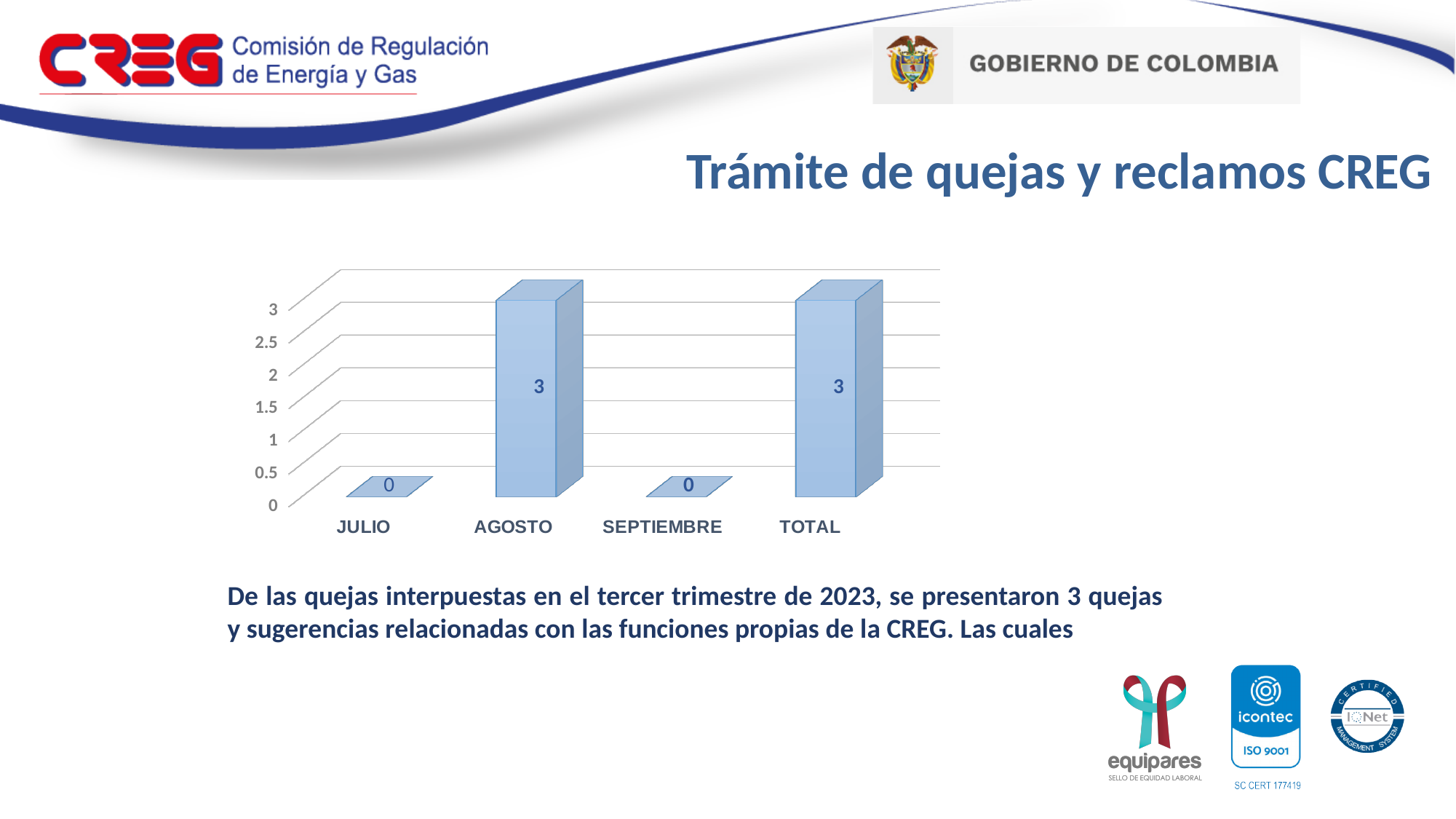
Is the value for AGOSTO greater or less than 2? greater What is the value for JULIO? 0 What is the value for AGOSTO? 3 What kind of chart is shown on the slide? bar chart What is the value for SEPTIEMBRE? 0 Which month among JULIO, AGOSTO and SEPTIEMBRE has the highest value? AGOSTO What is the highest value shown on the vertical axis? 3 How many categories are shown on the x axis? 4 What is the difference between the values for AGOSTO and JULIO? 3 What is the value for TOTAL? 3 What is the title of the slide containing the chart? Trámite de quejas y reclamos CREG Which is larger, the value for AGOSTO or the value for SEPTIEMBRE? AGOSTO